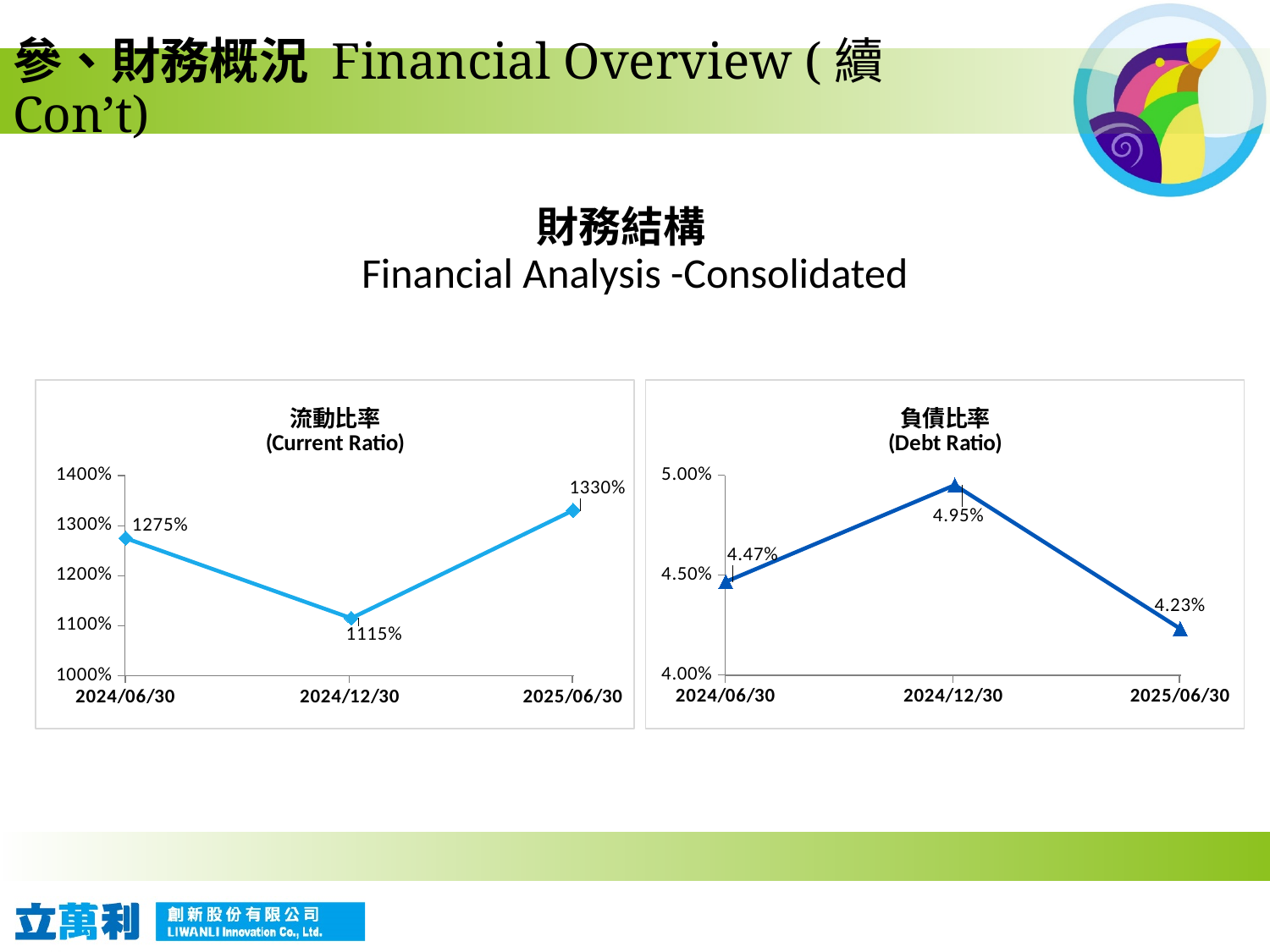
In the Debt Ratio chart, what is the value for 2024/12/30? 4.95% What kind of chart is the Debt Ratio chart? line chart In the Current Ratio chart, which date has the lowest value? 2024/12/30 In the Current Ratio chart, what is the difference between the values for 2025/06/30 and 2024/12/30? 215% In the Current Ratio chart, which date has the highest value? 2025/06/30 In the Debt Ratio chart, what is the difference between the values for 2024/12/30 and 2024/06/30? 0.48% In the Debt Ratio chart, which date has the lowest value? 2025/06/30 How many data points are plotted in the Current Ratio chart? 3 In the Debt Ratio chart, what is the value for 2025/06/30? 4.23% In the Debt Ratio chart, is the value for 2024/06/30 larger or smaller than the value for 2025/06/30? larger In the Current Ratio chart, what is the value for 2024/06/30? 1275% In the Current Ratio chart, what is the value for 2024/12/30? 1115%